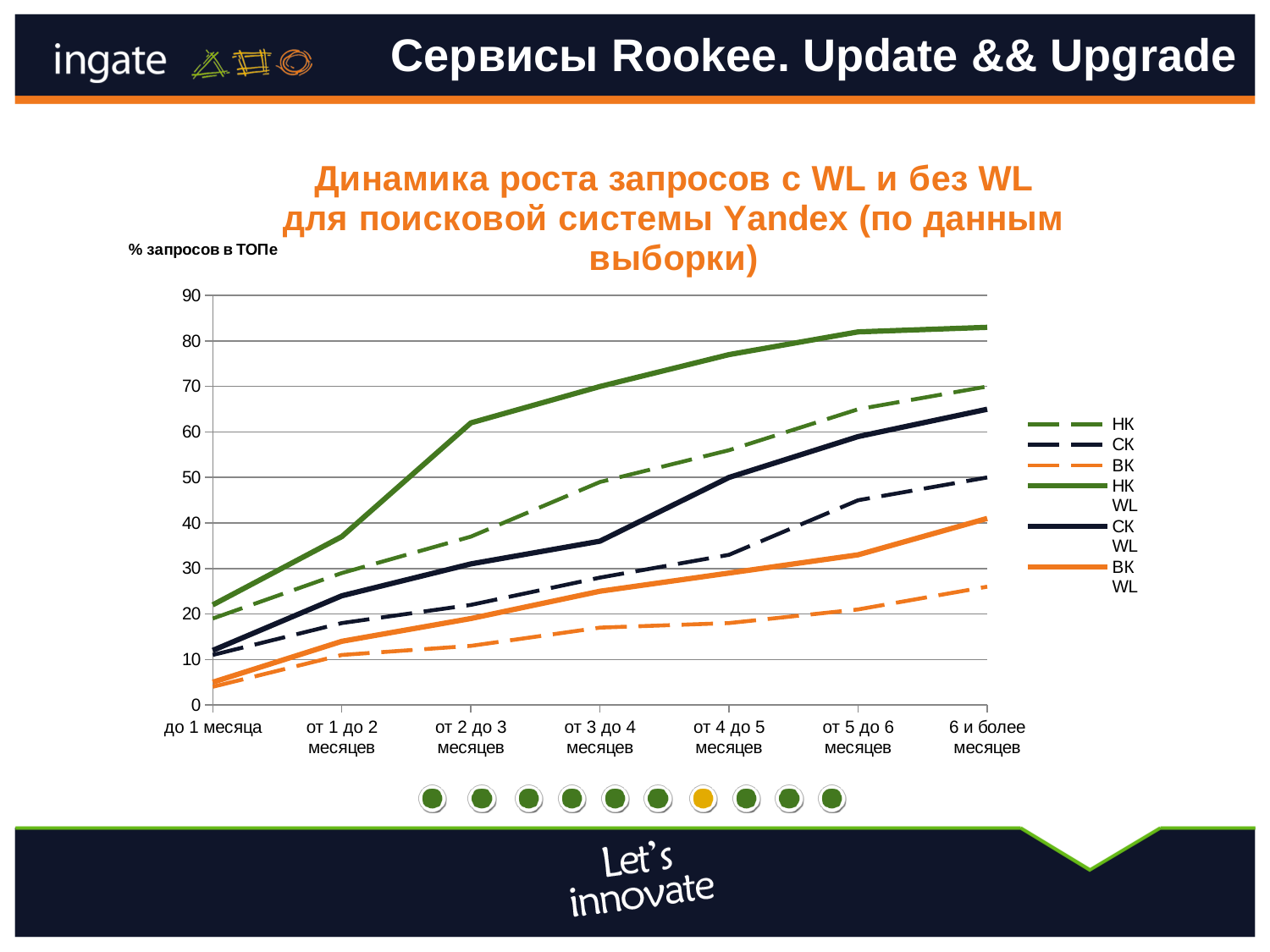
Is the value for НК WL at "от 1 до 2 месяцев" greater or less than 30? greater Is the value for ВК at "6 и более месяцев" greater or less than 20? greater Is the value for НК WL at "6 и более месяцев" greater or less than 80? greater What is the label on the vertical axis of the chart? % запросов в ТОПе Which is larger at "от 2 до 3 месяцев": НК WL or СК WL? НК WL Do the values for СК WL rise or fall along the x axis? rise Which series has the lowest value at "6 и более месяцев"? ВК How many series does the legend list? 6 Which series has the highest value at "6 и более месяцев"? НК WL What kind of chart is shown on the slide? line chart How many categories are shown along the x axis? 7